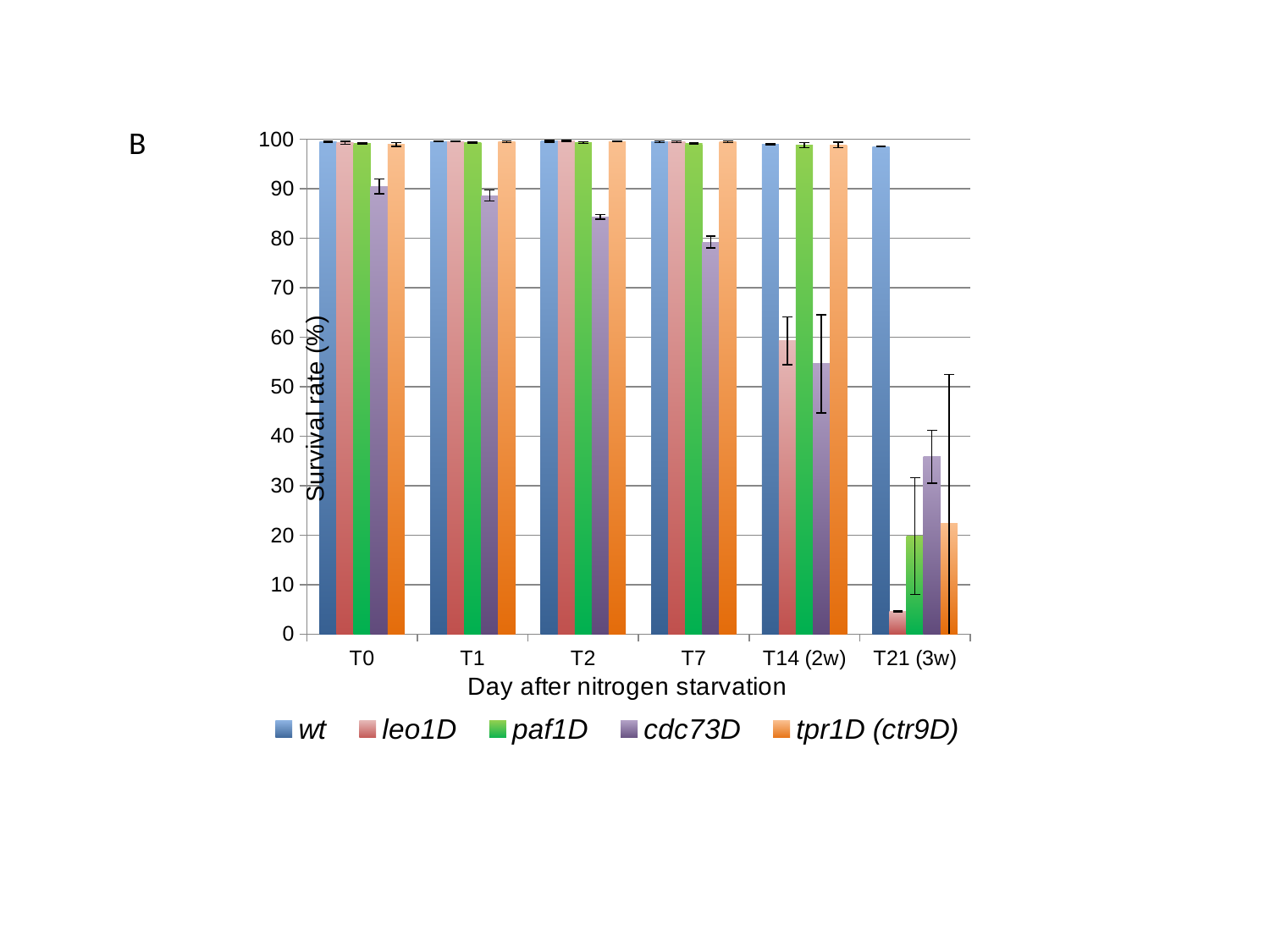
How many series does the legend list? 5 Is the survival rate for leo1D at T21 (3w) greater or less than 10? less Does the survival rate for cdc73D rise or fall from T0 to T21 (3w)? fall Is the survival rate for cdc73D at T21 (3w) greater or less than 30? greater At T14 (2w), which has the larger survival rate, paf1D or leo1D? paf1D At T21 (3w), which series has the highest survival rate? wt How many time-point categories are shown on the x axis? 6 Is the survival rate for cdc73D at T7 greater or less than 90? less At T21 (3w), which series has the lowest survival rate? leo1D What kind of chart is shown on the slide? bar chart What is the label of the y axis? Survival rate (%)